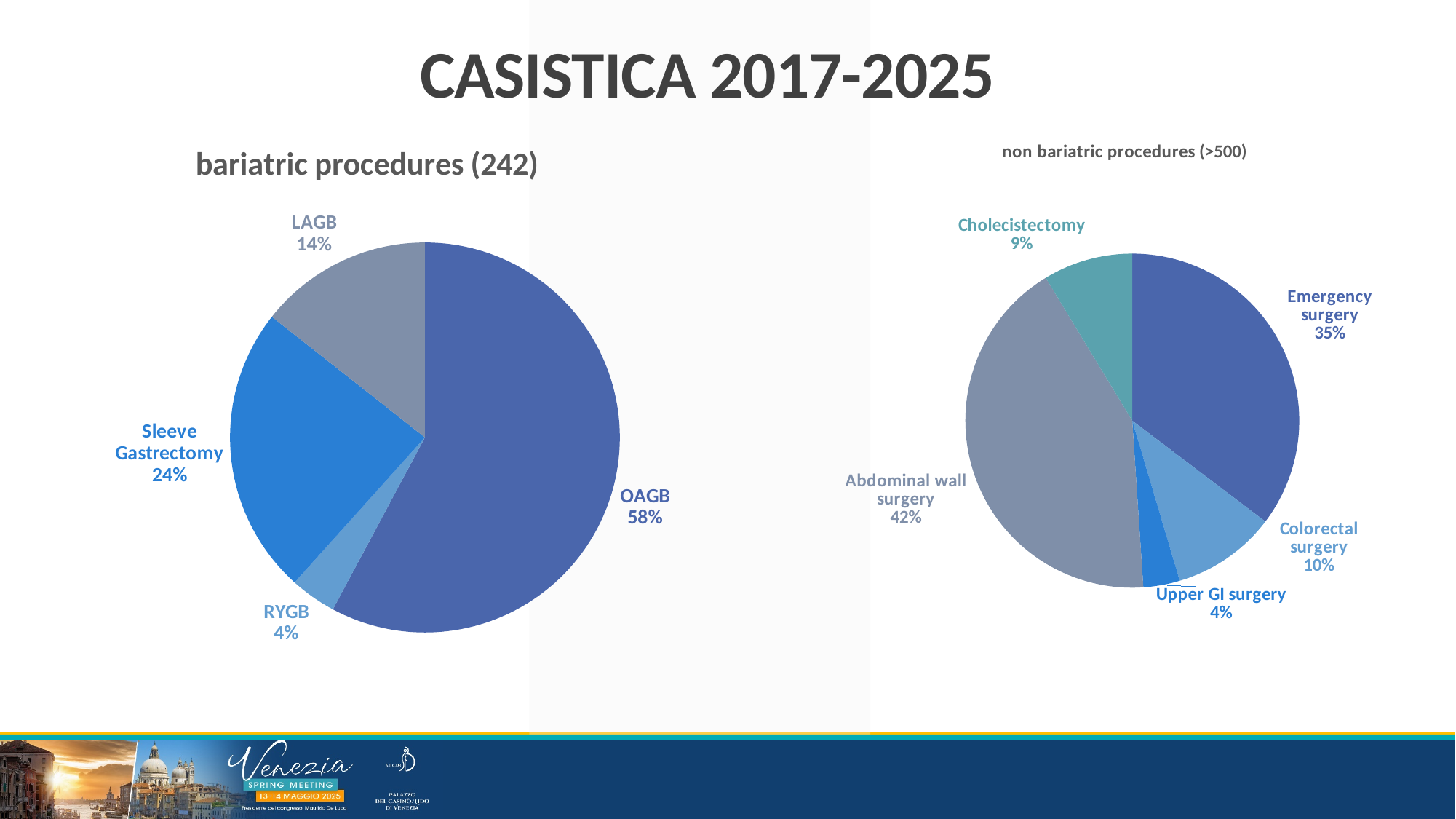
In the 'non bariatric procedures (>500)' chart, which category has the largest share? Abdominal wall surgery In the 'bariatric procedures (242)' chart, what share does Sleeve Gastrectomy have? 24% In the 'non bariatric procedures (>500)' chart, how many categories are shown? 5 What type of chart is used for the 'non bariatric procedures (>500)' data? Pie chart In the 'bariatric procedures (242)' chart, which procedure has the smallest share? RYGB In the 'bariatric procedures (242)' chart, what share does OAGB have? 58% In the 'bariatric procedures (242)' chart, how many slices does the pie have? 4 In the 'bariatric procedures (242)' chart, what is the difference in percentage points between OAGB and Sleeve Gastrectomy? 34 In the 'non bariatric procedures (>500)' chart, what share does Cholecistectomy have? 9% In the 'non bariatric procedures (>500)' chart, what share does Abdominal wall surgery have? 42% In the 'non bariatric procedures (>500)' chart, which is larger, Emergency surgery or Colorectal surgery? Emergency surgery In the 'bariatric procedures (242)' chart, which procedure has the largest share? OAGB